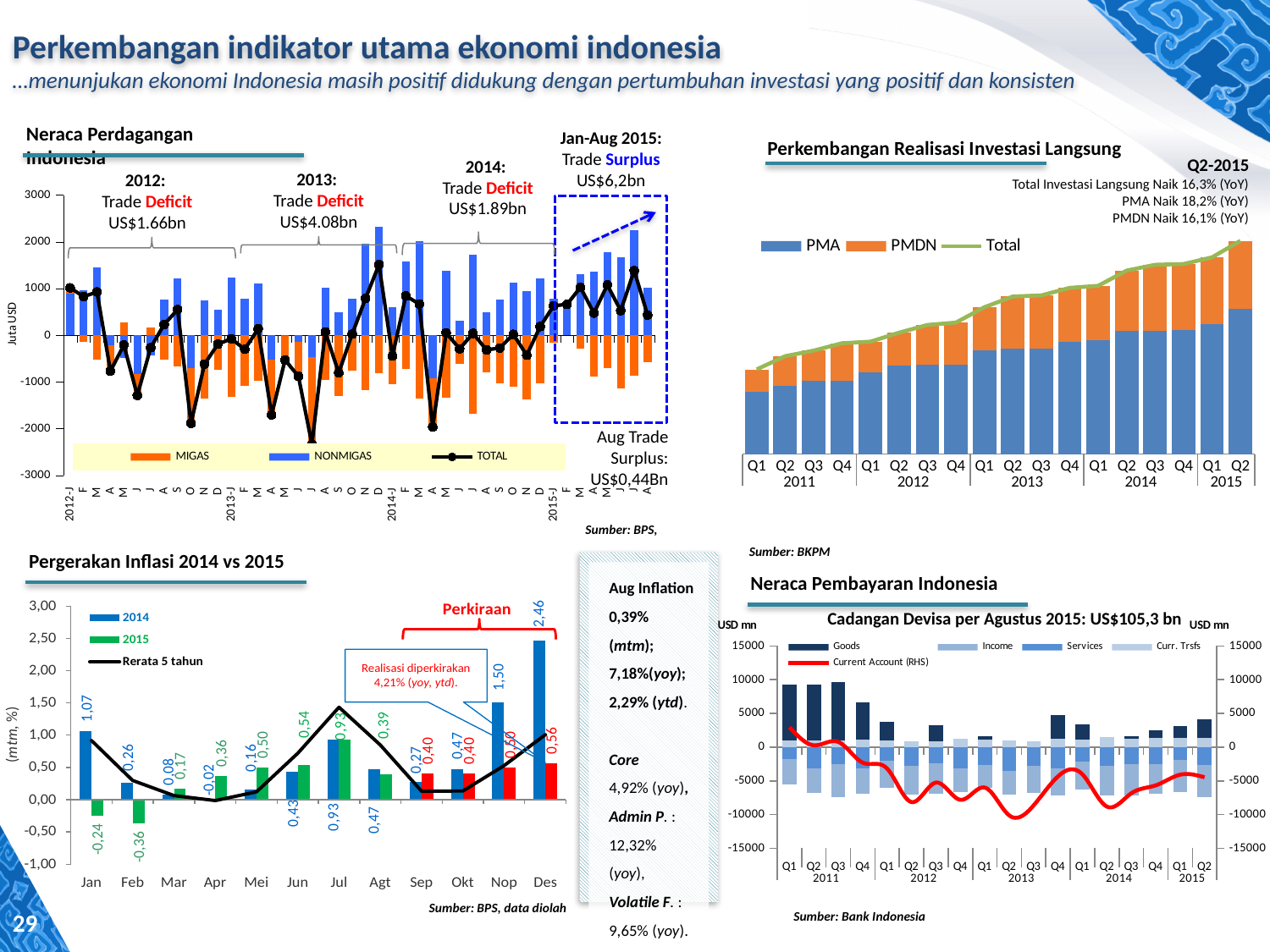
In the 'Pergerakan Inflasi 2014 vs 2015' chart, what is the 2015 value for Feb? -0,36 In the 'Pergerakan Inflasi 2014 vs 2015' chart, which is larger for Mei: the 2014 value or the 2015 value? 2015 In the 'Pergerakan Inflasi 2014 vs 2015' chart, what is the 2014 value for Des? 2,46 In the 'Perkembangan Realisasi Investasi Langsung' chart, does the Total line rise or fall from Q1 2011 to Q2 2015? rise In the 'Pergerakan Inflasi 2014 vs 2015' chart, what is the 2014 value for Jan? 1,07 How many months are shown on the x axis of the 'Pergerakan Inflasi 2014 vs 2015' chart? 12 How many series does the legend of the 'Perkembangan Realisasi Investasi Langsung' chart list? 3 In the 'Pergerakan Inflasi 2014 vs 2015' chart, what is the difference between the 2014 and 2015 values for Jan? 1,31 How many series does the legend of the 'Neraca Pembayaran Indonesia' chart list? 5 In the 'Pergerakan Inflasi 2014 vs 2015' chart, which month has the highest 2014 value? Des How many series does the legend of the 'Pergerakan Inflasi 2014 vs 2015' chart list? 3 In the 'Pergerakan Inflasi 2014 vs 2015' chart, which month has the lowest 2015 value? Feb